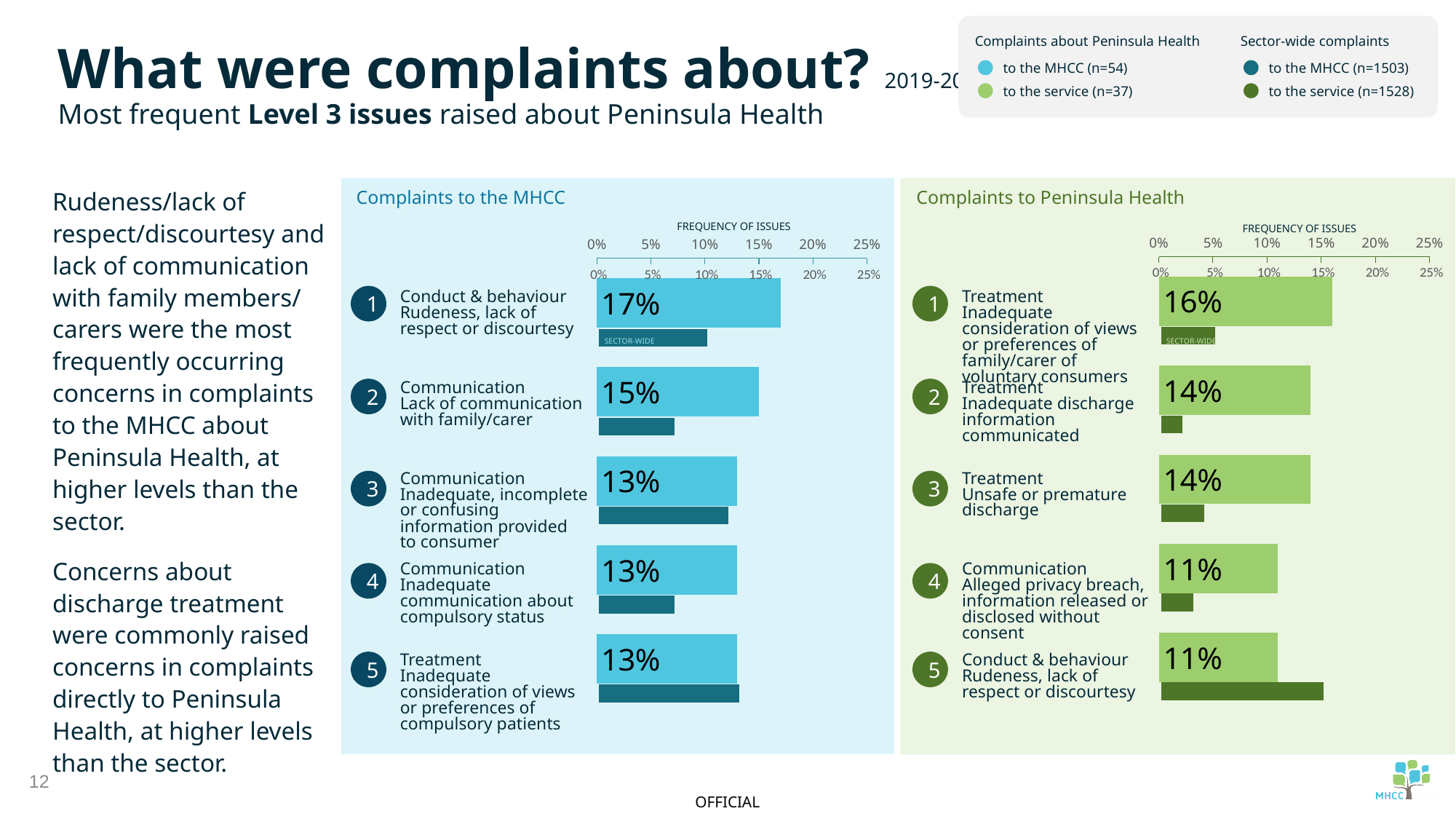
How many issues are listed in the 'Complaints to Peninsula Health' chart? 5 In the 'Complaints to the MHCC' chart, what is the frequency for Conduct & behaviour – Rudeness, lack of respect or discourtesy? 17% In the 'Complaints to Peninsula Health' chart, which issue has the highest frequency? Treatment – Inadequate consideration of views or preferences of family/carer of voluntary consumers In the 'Complaints to Peninsula Health' chart, what is the difference between the highest frequency (16%) and the frequency for Rudeness, lack of respect or discourtesy? 5 percentage points In the 'Complaints to the MHCC' chart, what is the frequency for Communication – Lack of communication with family/carer? 15% In the 'Complaints to Peninsula Health' chart, what is the frequency for Treatment – Unsafe or premature discharge? 14% Which is larger: the top issue frequency in the 'Complaints to the MHCC' chart or the top issue frequency in the 'Complaints to Peninsula Health' chart? Complaints to the MHCC (17%) In the 'Complaints to the MHCC' chart, which issue has the highest frequency? Conduct & behaviour – Rudeness, lack of respect or discourtesy In the 'Complaints to the MHCC' chart, what is the difference in frequency between the Rudeness, lack of respect or discourtesy issue and the Lack of communication with family/carer issue? 2 percentage points In the 'Complaints to the MHCC' chart, is the sector-wide value for Rudeness, lack of respect or discourtesy greater or less than 15%? less In the 'Complaints to Peninsula Health' chart, is the sector-wide value for Rudeness, lack of respect or discourtesy greater or less than 10%? greater In the 'Complaints to Peninsula Health' chart, what is the frequency for Communication – Alleged privacy breach, information released or disclosed without consent? 11%